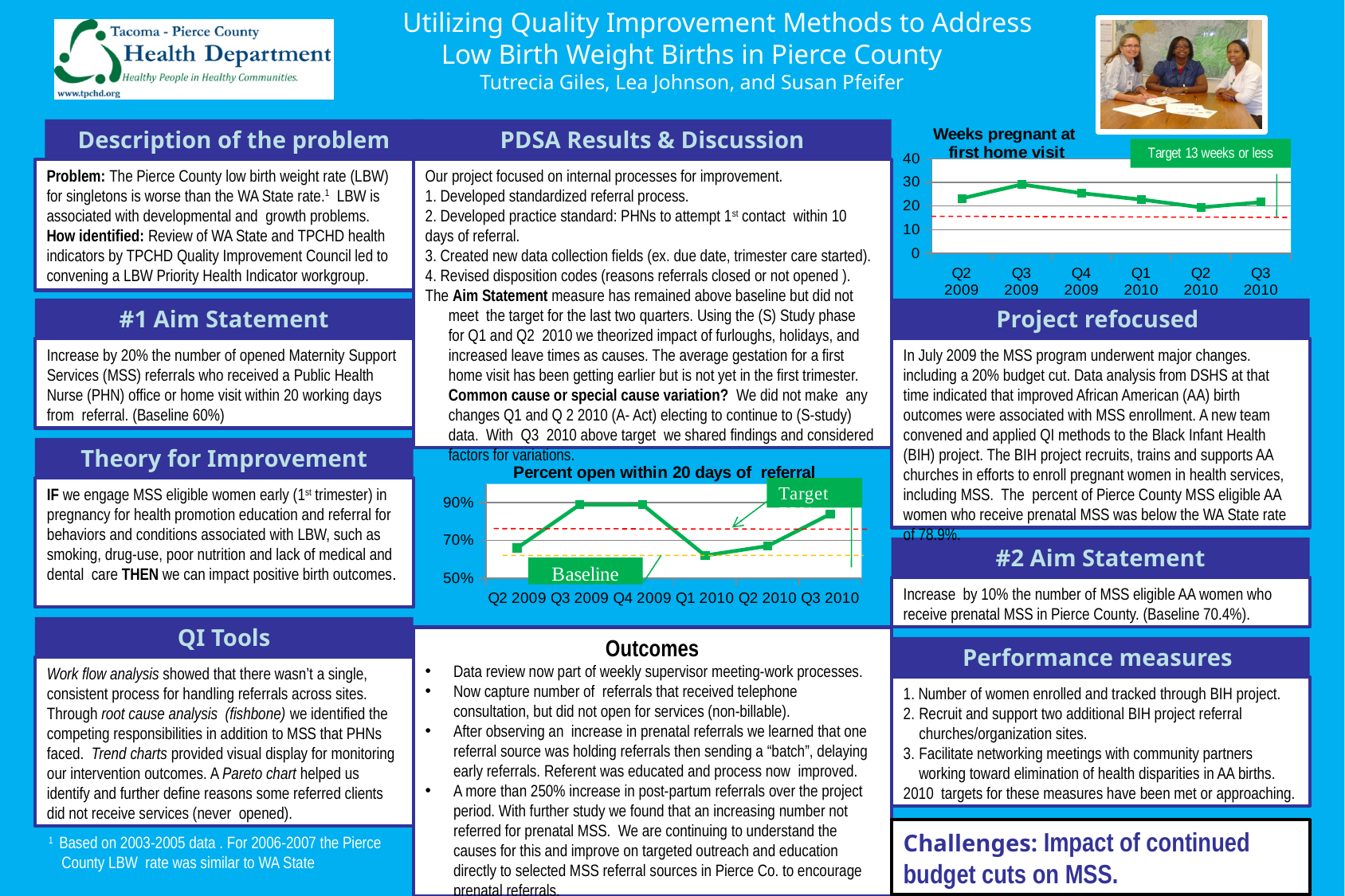
What kind of chart is the 'Percent open within 20 days of referral' chart? line chart How many quarters are plotted on the 'Percent open within 20 days of referral' chart? 6 On the 'Weeks pregnant at first home visit' chart, what target is stated in the label box? Target 13 weeks or less On the 'Percent open within 20 days of referral' chart, is the value for Q3 2009 greater or less than 70%? greater On the 'Percent open within 20 days of referral' chart, which is larger, the value for Q4 2009 or the value for Q2 2010? Q4 2009 On the 'Weeks pregnant at first home visit' chart, is the value for Q2 2010 greater or less than 10? greater On the 'Percent open within 20 days of referral' chart, is the value for Q1 2010 greater or less than 70%? less How many quarters are plotted on the 'Weeks pregnant at first home visit' chart? 6 On the 'Weeks pregnant at first home visit' chart, do the values rise or fall from Q3 2009 to Q2 2010? fall What kind of chart is the 'Weeks pregnant at first home visit' chart? line chart On the 'Weeks pregnant at first home visit' chart, which quarter has the highest value? Q3 2009